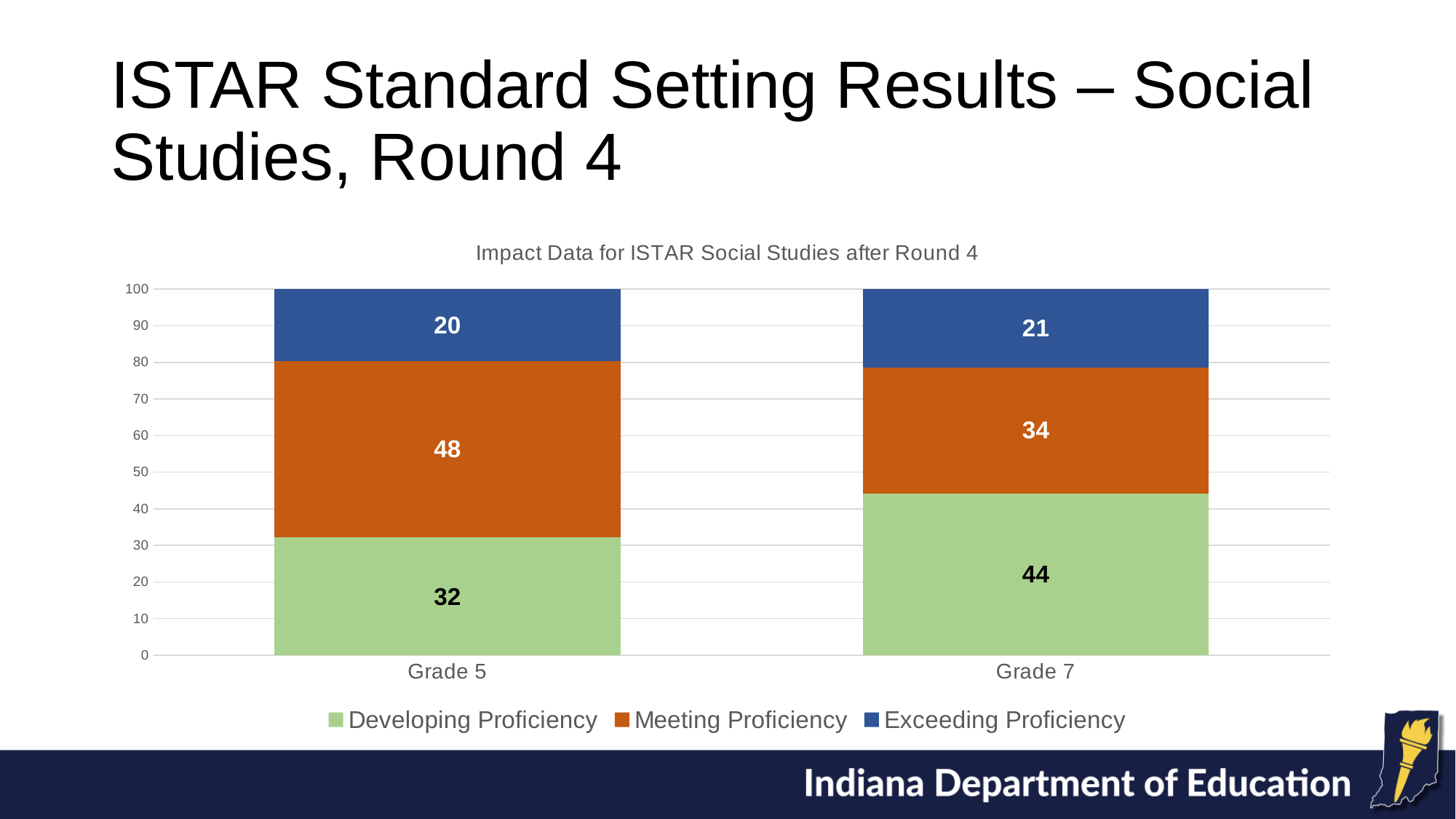
What is the Exceeding Proficiency value for Grade 5? 20 What is the difference between the Meeting Proficiency values for Grade 5 and Grade 7? 14 Which grade has the lower Developing Proficiency value? Grade 5 Which grade has the higher Meeting Proficiency value? Grade 5 What kind of chart is shown on the slide? Stacked bar chart What is the title of the chart? Impact Data for ISTAR Social Studies after Round 4 What is the Meeting Proficiency value for Grade 7? 34 What is the Developing Proficiency value for Grade 7? 44 What is the total of the stacked bar for Grade 7? 99 How many series does the legend list? 3 What is the Developing Proficiency value for Grade 5? 32 How many grade categories are shown on the x axis? 2